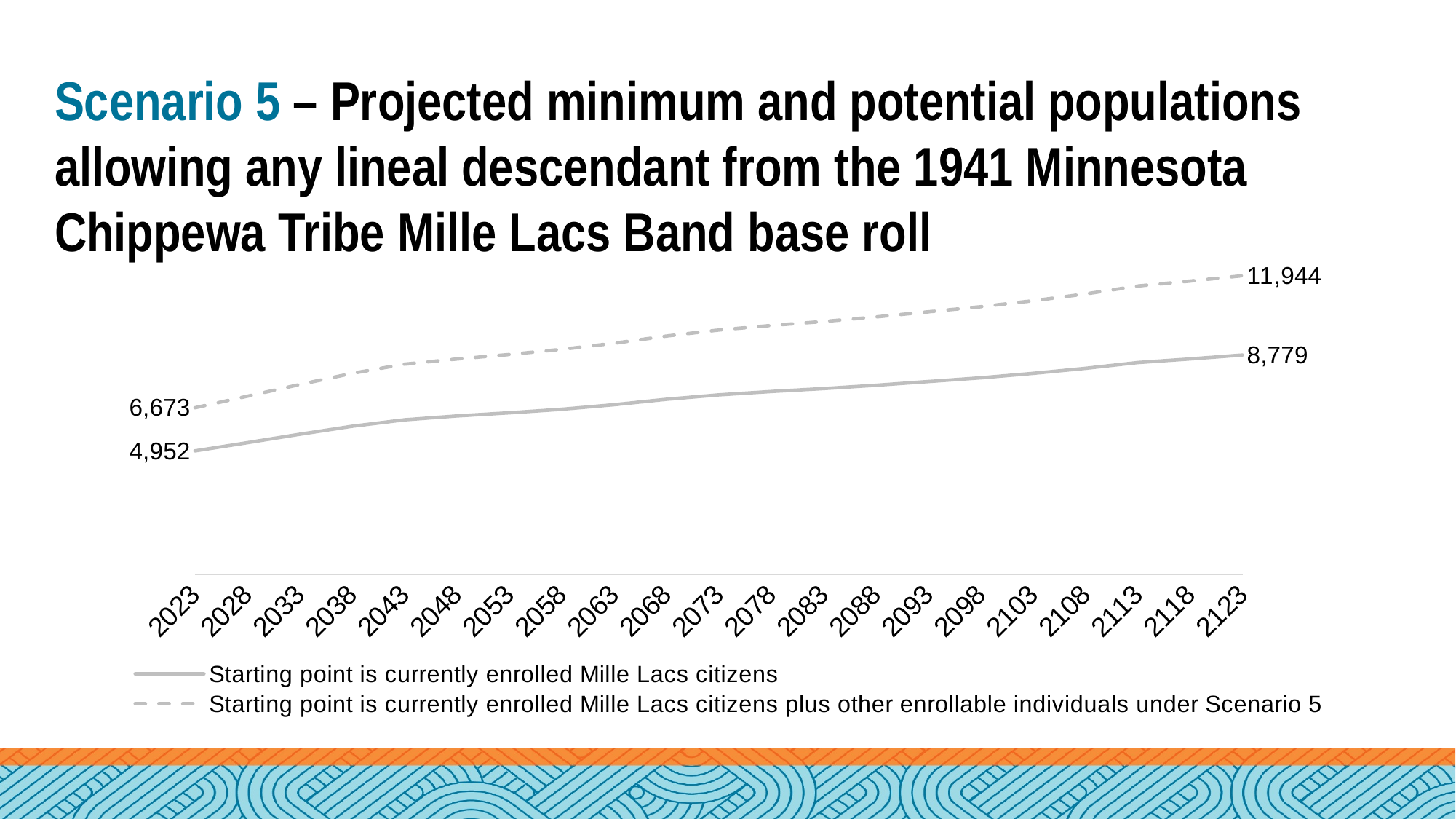
Which series is drawn with a dashed line? Starting point is currently enrolled Mille Lacs citizens plus other enrollable individuals under Scenario 5 What kind of chart is shown on the slide? line chart Do the values of the dashed-line series rise or fall from 2023 to 2123? rise How many year labels are shown on the x axis? 21 What is the difference between the two series' values in 2123? 3,165 What is the 2123 value for the series 'Starting point is currently enrolled Mille Lacs citizens plus other enrollable individuals under Scenario 5'? 11,944 What is the 2023 value for the series 'Starting point is currently enrolled Mille Lacs citizens'? 4,952 Which series has the higher value in 2123? Starting point is currently enrolled Mille Lacs citizens plus other enrollable individuals under Scenario 5 What is the 2123 value for the series 'Starting point is currently enrolled Mille Lacs citizens'? 8,779 How many series does the legend list? 2 What is the 2023 value for the series 'Starting point is currently enrolled Mille Lacs citizens plus other enrollable individuals under Scenario 5'? 6,673 By how much does the solid-line series 'Starting point is currently enrolled Mille Lacs citizens' increase from 2023 to 2123? 3,827